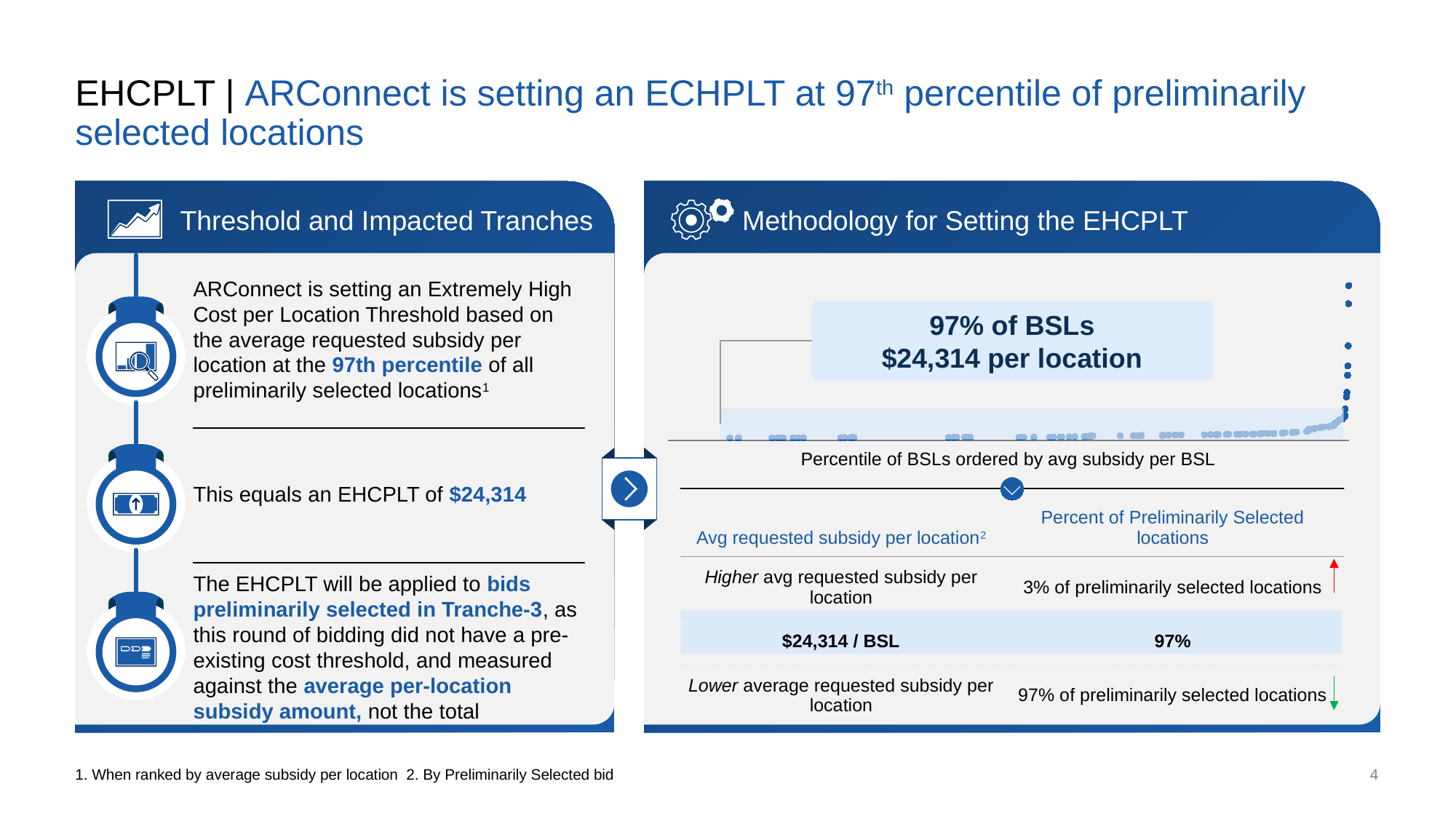
What is the x-axis label of the chart in the Methodology for Setting the EHCPLT panel? Percentile of BSLs ordered by avg subsidy per BSL In the chart, what percentage of BSLs does the highlighted callout refer to? 97% of BSLs In the chart, what avg subsidy per location is marked at the 97% of BSLs point? $24,314 per location Which panel heading sits above the chart on the slide? Methodology for Setting the EHCPLT Do the plotted values in the chart rise or fall moving left to right along the x axis? rise What kind of chart is shown in the Methodology for Setting the EHCPLT panel? scatter chart